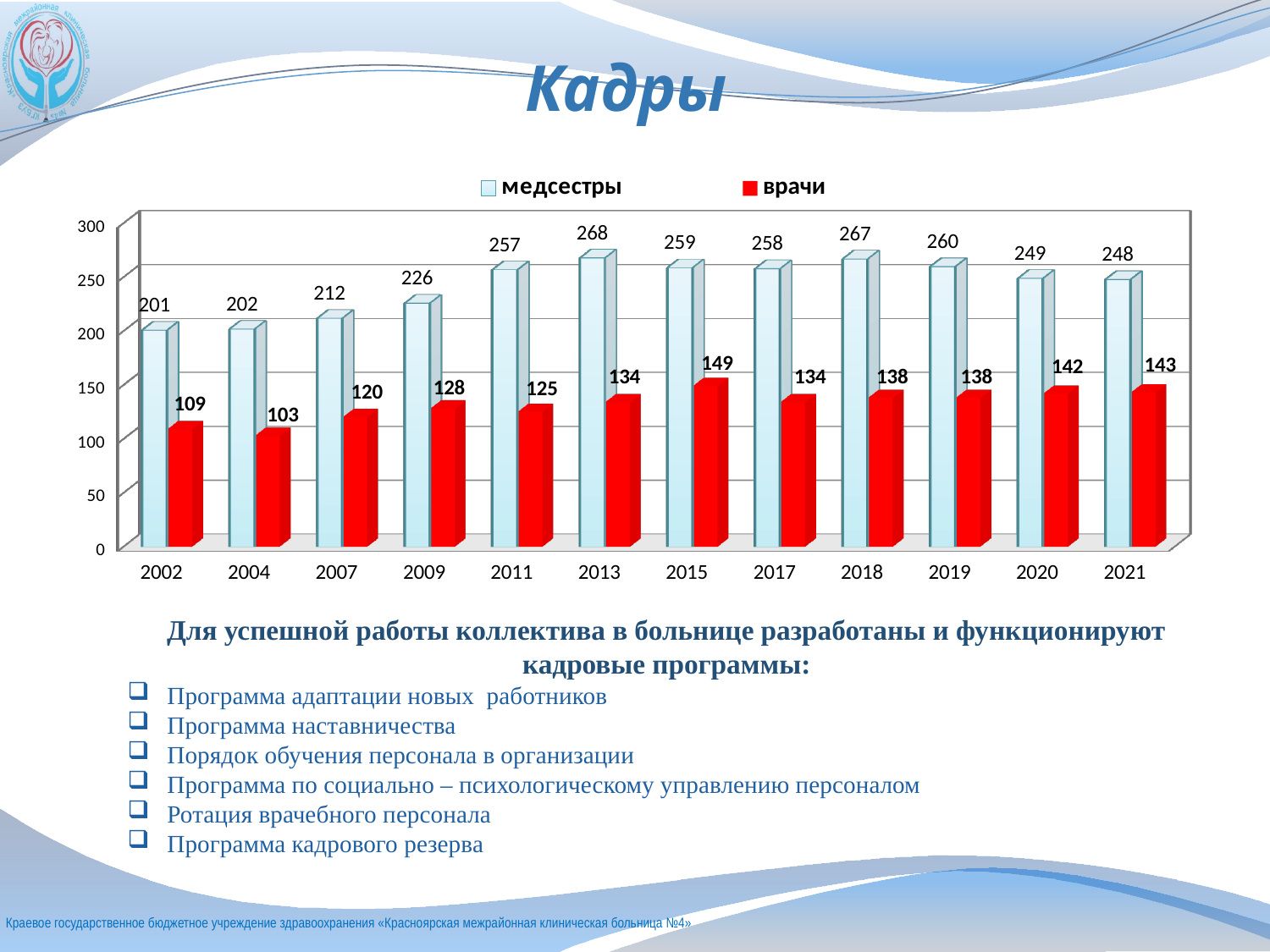
How many years are shown on the x axis? 12 How many series does the legend list? 2 What is the value for врачи in 2021? 143 What is the difference between медсестры and врачи in 2015? 110 What kind of chart is shown on the slide? bar chart In which year is the value for медсестры highest? 2013 What is the value for врачи in 2004? 103 What is the value for медсестры in 2013? 268 In which year is the value for врачи lowest? 2004 Which is larger: врачи in 2002 or врачи in 2007? врачи in 2007 What colour are the bars for врачи? red Do the values for медсестры rise or fall from 2002 to 2013? rise